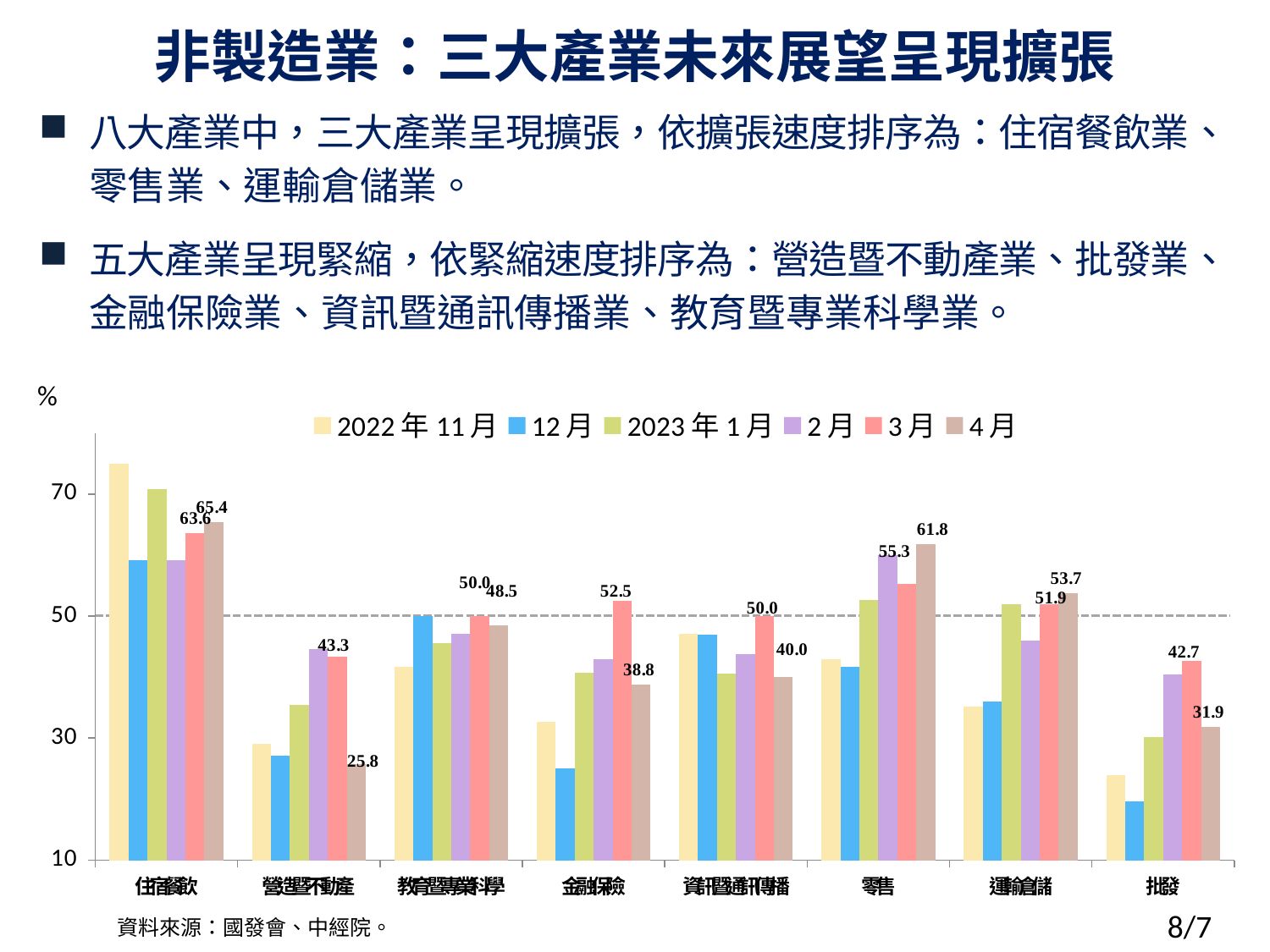
What is the value for 營造暨不動產 in 4月? 25.8 Which category has the highest value in 4月? 住宿餐飲 What kind of chart is shown on the slide? bar chart Is the value for 住宿餐飲 in 2022年11月 greater or less than 70? greater What is the value for 零售 in 3月? 55.3 What is the value for 住宿餐飲 in 4月? 65.4 Which category has the lowest value in 4月? 營造暨不動產 What is the difference between the 4月 and 3月 values for 金融保險? 13.7 How many series does the legend list? 6 What is the first series listed in the legend? 2022年11月 How many categories are shown on the x axis? 8 Which is larger for 批發: the 3月 value or the 4月 value? 3月